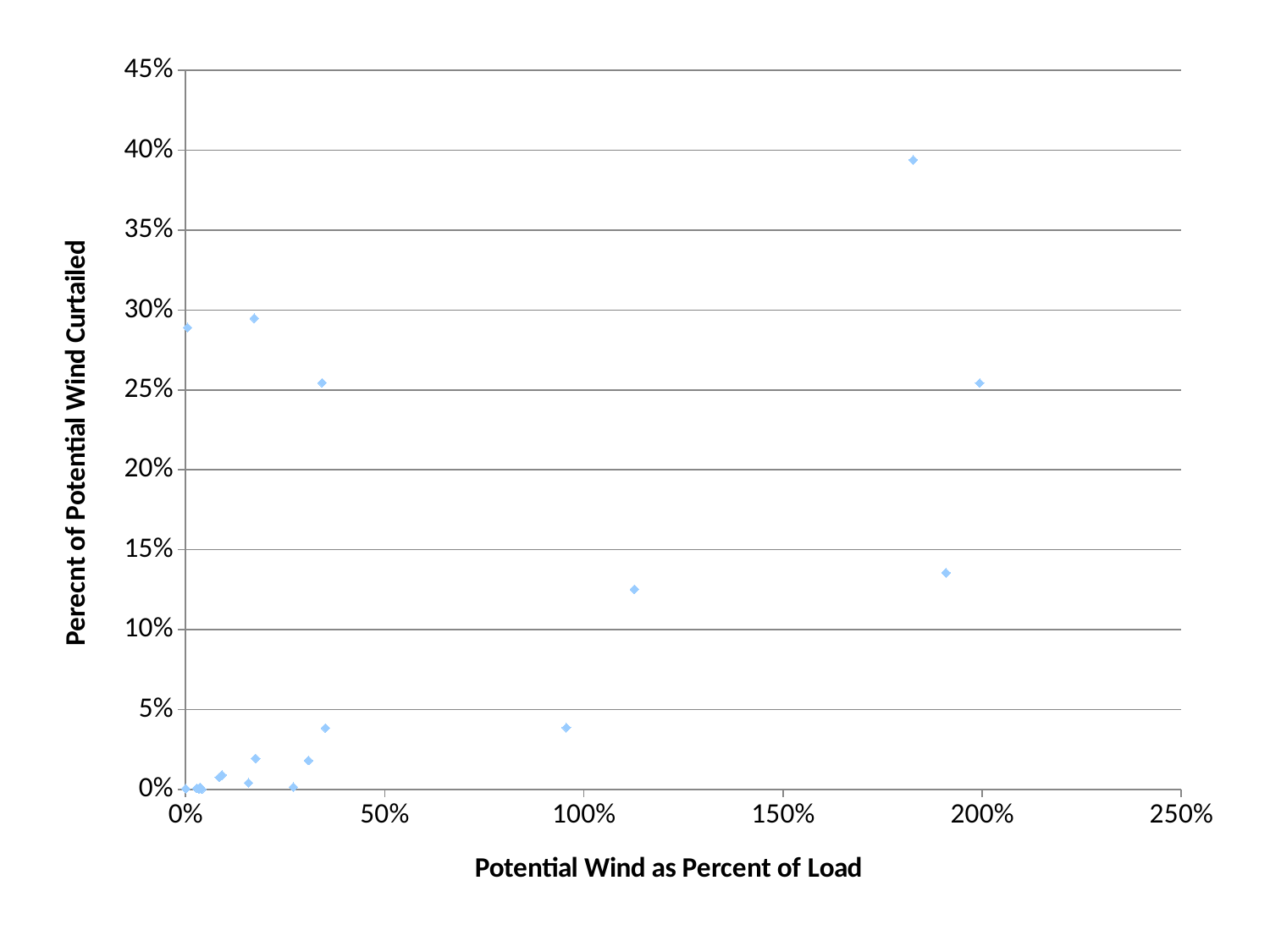
Is the curtailment value of the highest plotted point greater or less than 35%? greater Is the curtailment value of the point plotted near 191% on the horizontal axis greater or less than 15%? less Is the horizontal-axis value of the highest plotted point greater or less than 150%? greater Which point has the higher curtailment value: the one plotted near 113% or the one plotted near 95% on the horizontal axis? The one near 113% What kind of chart is shown on the slide? Scatter chart What is the title of the horizontal axis? Potential Wind as Percent of Load What is the highest tick value shown on the vertical axis? 45% What is the highest tick value shown on the horizontal axis? 250% What is the title of the vertical axis? Perecnt of Potential Wind Curtailed